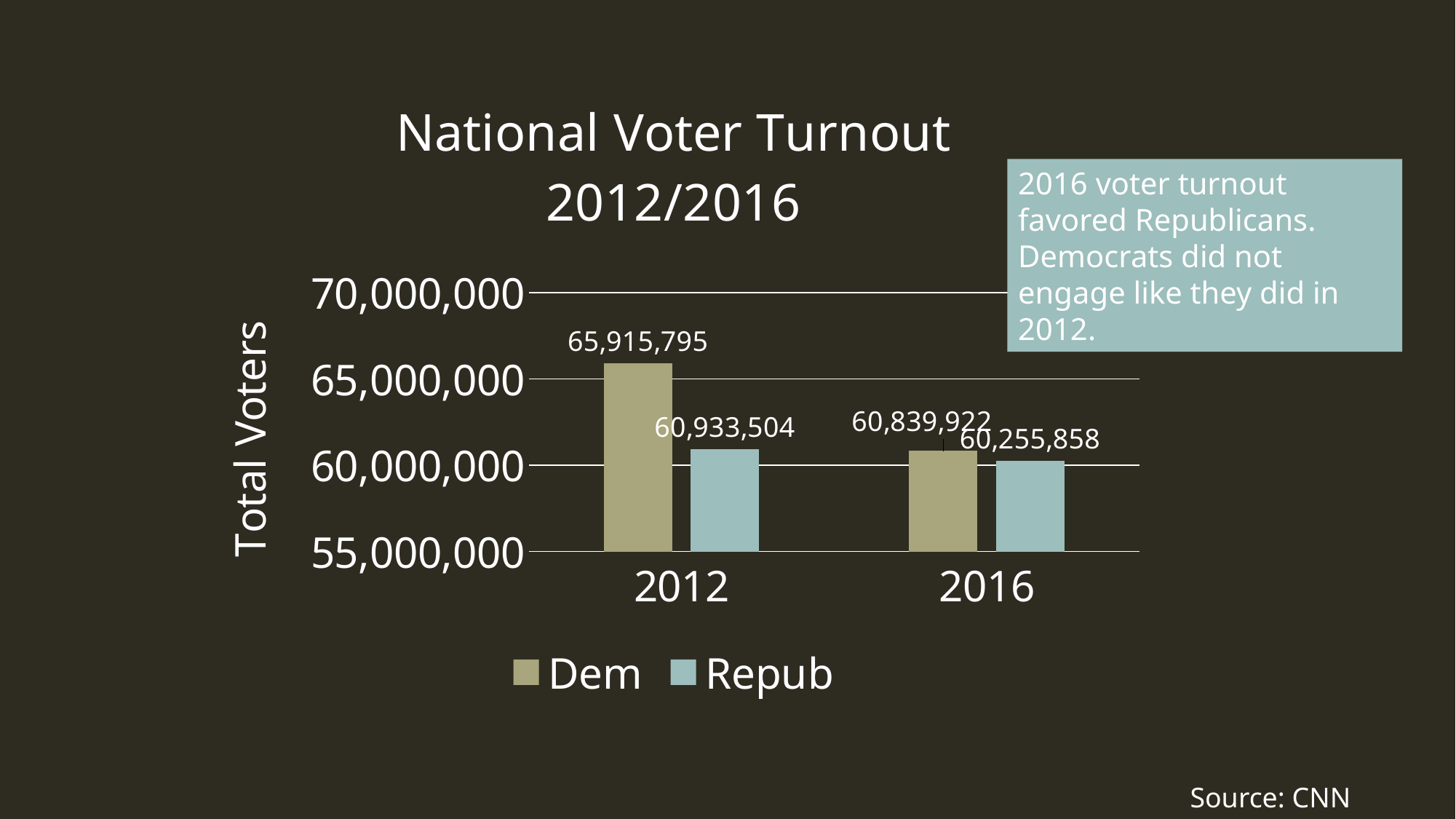
What was the Repub voter turnout in 2012? 60,933,504 By how much did the Dem turnout fall from 2012 to 2016? 5,075,873 What is the difference between the Dem and Repub turnout in 2012? 4,982,291 Which was larger in 2016, the Dem turnout or the Repub turnout? Dem What was the Repub voter turnout in 2016? 60,255,858 Is the Dem turnout in 2012 greater or less than 65,000,000? greater What was the Dem voter turnout in 2012? 65,915,795 What was the Dem voter turnout in 2016? 60,839,922 Which bar shows the lowest voter turnout on the chart? Repub in 2016 How many series does the legend list? 2 What kind of chart is shown on the slide? Bar chart Which bar shows the highest voter turnout on the chart? Dem in 2012